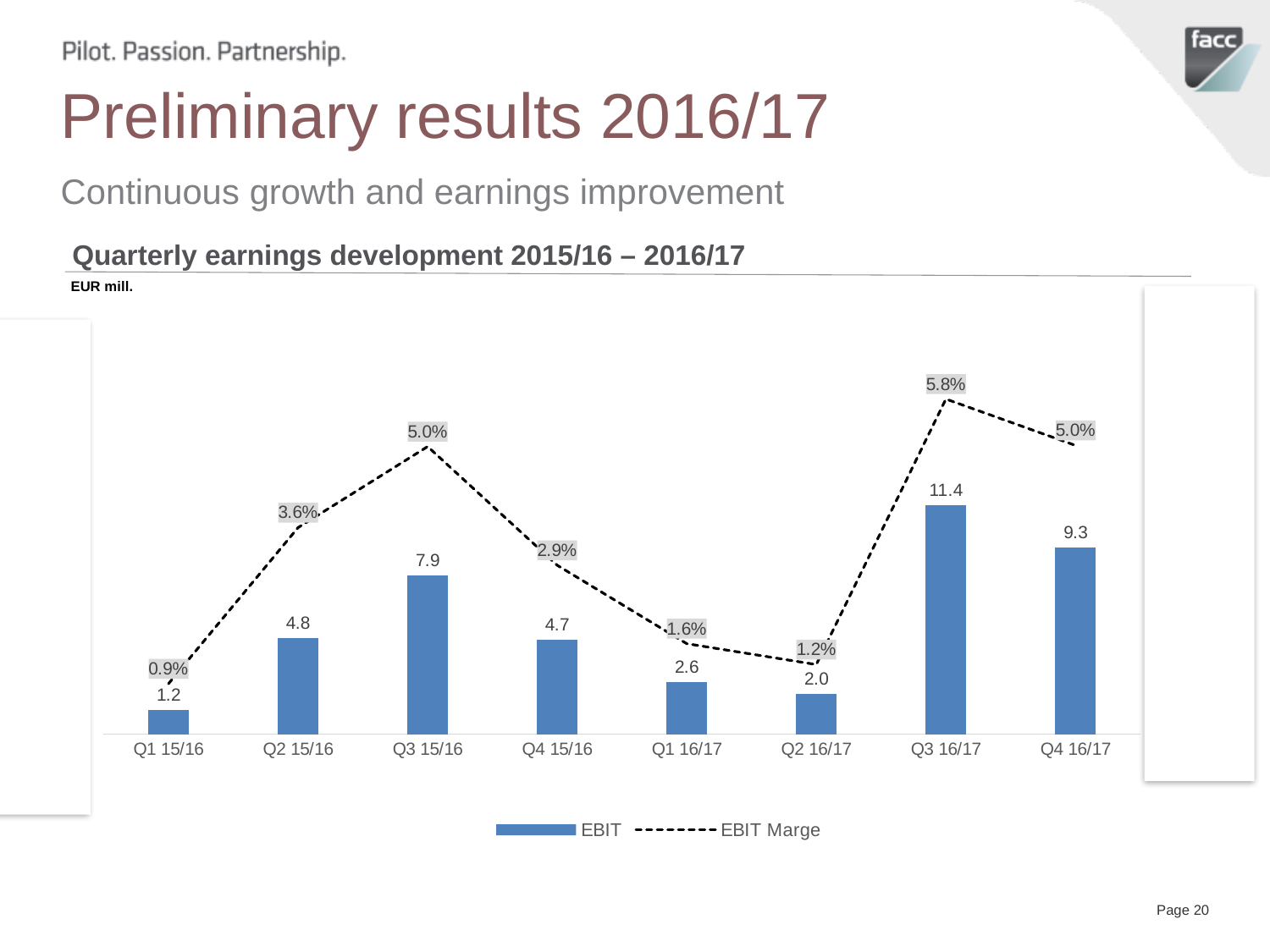
How many quarters are shown on the x axis? 8 What is the EBIT Marge for Q2 15/16? 3.6% How many series does the legend list? 2 What is the difference in EBIT between Q3 16/17 and Q4 16/17? 2.1 Which quarter has the highest EBIT? Q3 16/17 What unit is stated for the chart values? EUR mill. What is the EBIT value for Q1 15/16? 1.2 Which quarter has the larger EBIT, Q3 15/16 or Q4 16/17? Q4 16/17 Does the EBIT Marge rise or fall from Q3 15/16 to Q2 16/17? Fall What is the EBIT value for Q3 16/17? 11.4 What kind of chart is used to show EBIT? Bar chart Which quarter has the lowest EBIT Marge? Q1 15/16